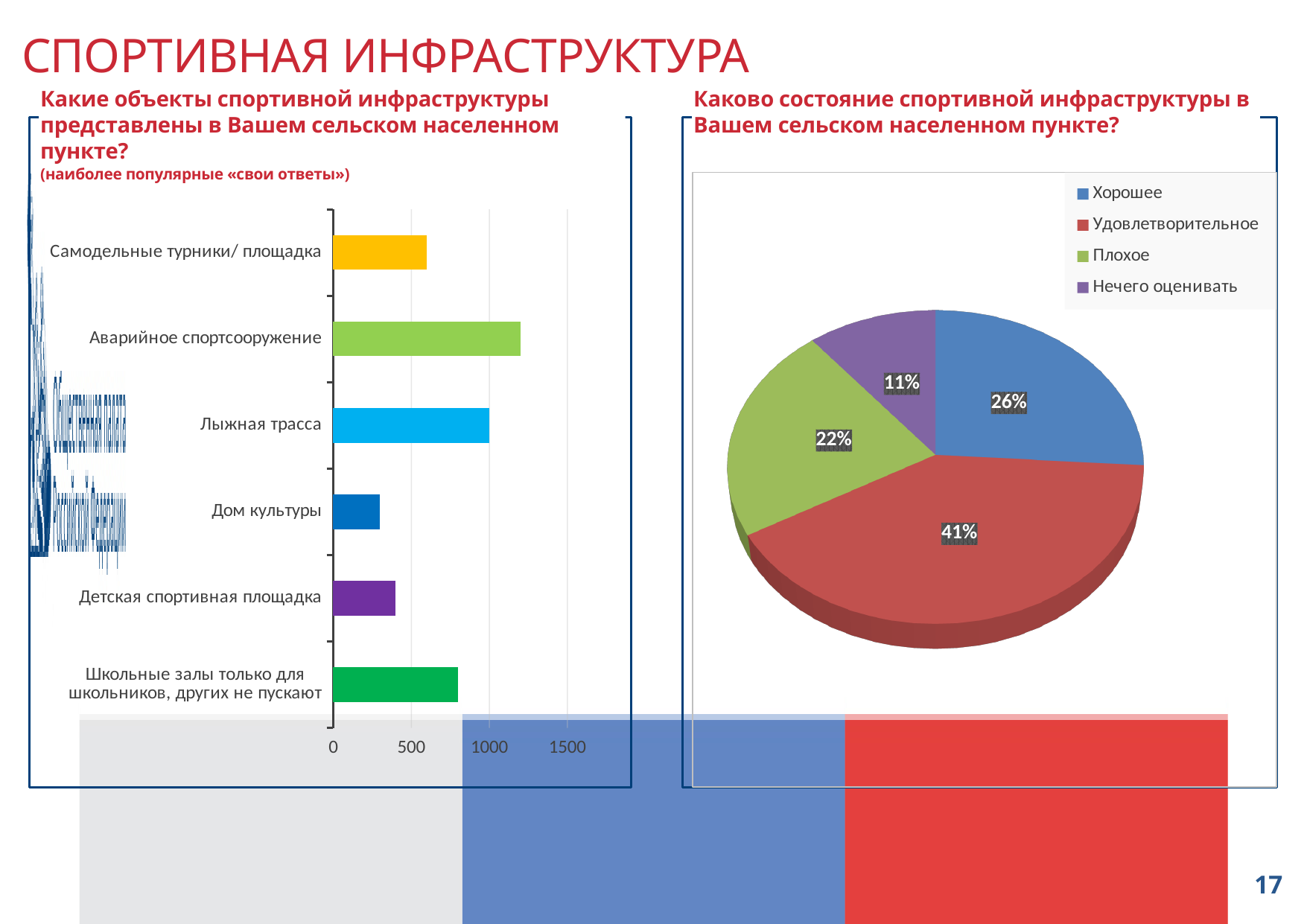
On the pie chart on the right, how many percentage points larger is the «Удовлетворительное» share than the «Хорошее» share? 15 On the pie chart on the right, what share of respondents answered «Нечего оценивать»? 11% What kind of chart is the chart on the left of the slide? Bar chart On the bar chart on the left, is the value for «Аварийное спортсооружение» greater or less than 1000? greater On the pie chart on the right, how many entries does the legend list? 4 On the bar chart on the left, is the value for «Дом культуры» greater or less than 500? less On the pie chart on the right, which answer has the largest share? Удовлетворительное On the pie chart on the right, what share of respondents answered «Удовлетворительное»? 41% On the bar chart on the left, which category has the longest bar? Аварийное спортсооружение On the pie chart on the right, what share of respondents answered «Хорошее»? 26% On the bar chart on the left, how many categories are shown? 6 On the pie chart on the right, which answer has the smallest share? Нечего оценивать